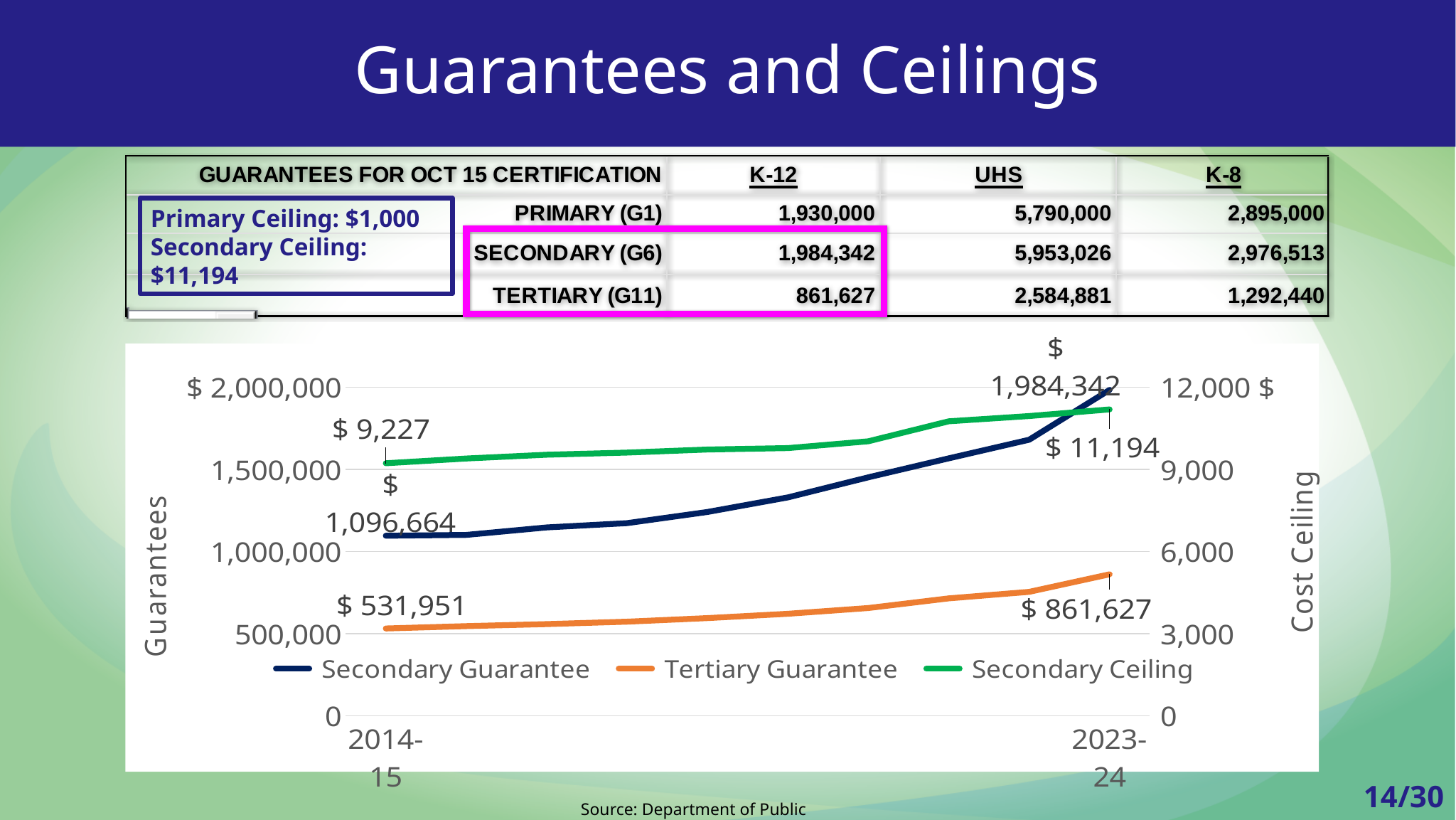
What is the title of the right-hand vertical axis of the chart? Cost Ceiling What is the value of the Secondary Ceiling in 2023-24? $ 11,194 By how much did the Secondary Guarantee increase from 2014-15 to 2023-24? 887,678 By how much did the Secondary Ceiling increase from 2014-15 to 2023-24? 1,967 How many series does the chart's legend list? 3 What is the value of the Secondary Guarantee in 2014-15? $ 1,096,664 What is the value of the Tertiary Guarantee in 2014-15? $ 531,951 Does the Tertiary Guarantee rise or fall from 2014-15 to 2023-24? Rise What is the value of the Secondary Guarantee in 2023-24? $ 1,984,342 Which is larger in 2023-24, the Secondary Guarantee or the Tertiary Guarantee? Secondary Guarantee What kind of chart is shown on the slide? Line chart What is the value of the Tertiary Guarantee in 2023-24? $ 861,627